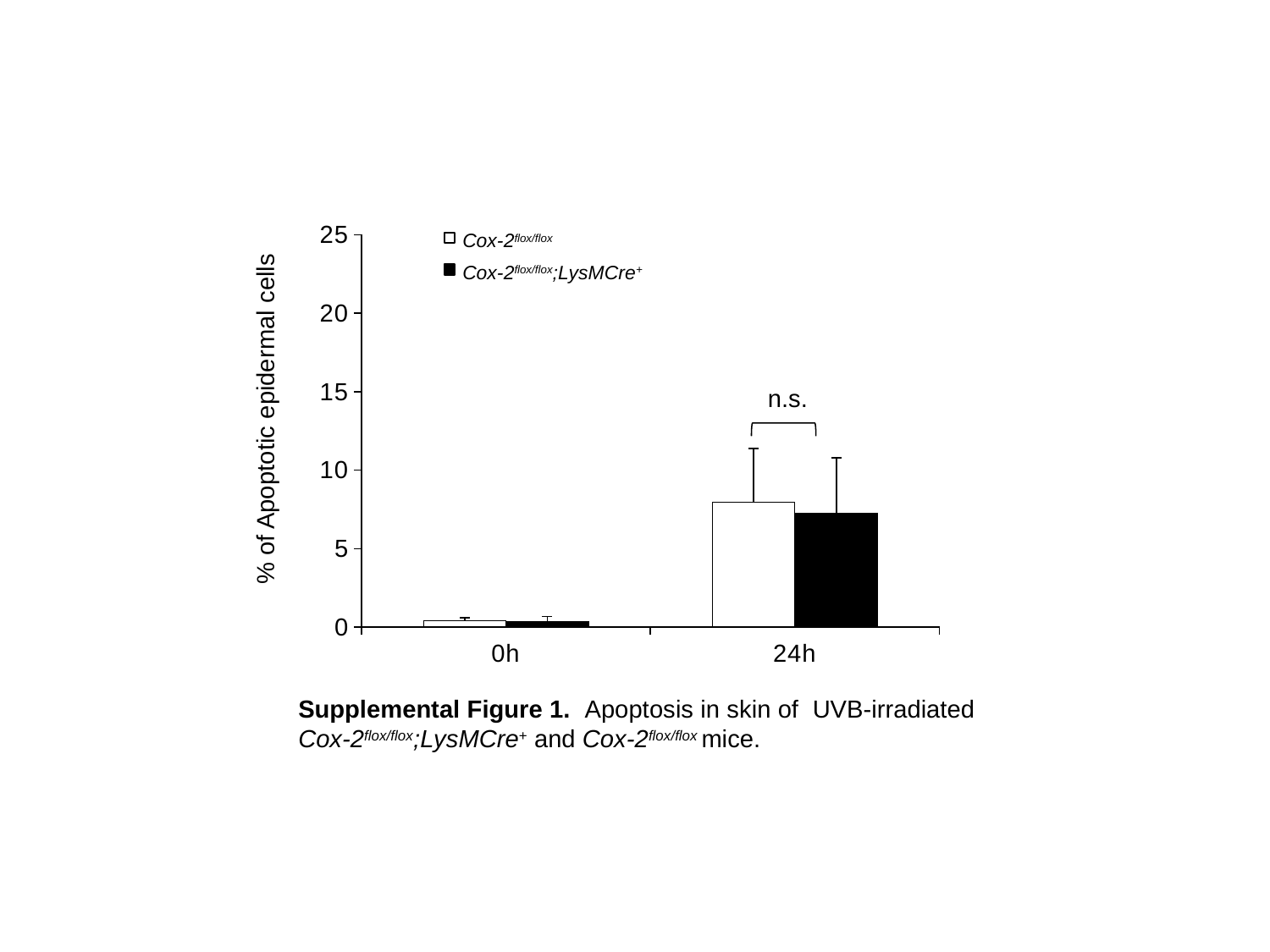
Do the values for both series rise or fall from 0h to 24h? rise For the Cox-2flox/flox series, which time point has the higher value, 0h or 24h? 24h How many series does the legend list? 2 Is the value for Cox-2flox/flox at 24h greater or less than 10? less What is the y-axis label of the chart? % of Apoptotic epidermal cells How many categories are shown on the x axis? 2 Is the value for Cox-2flox/flox;LysMCre+ at 0h greater or less than 5? less What kind of chart is shown on the slide? bar chart Which series is drawn with black bars? Cox-2flox/flox;LysMCre+ For the Cox-2flox/flox;LysMCre+ series, which time point has the lowest value? 0h Is the value for Cox-2flox/flox at 24h greater or less than 5? greater